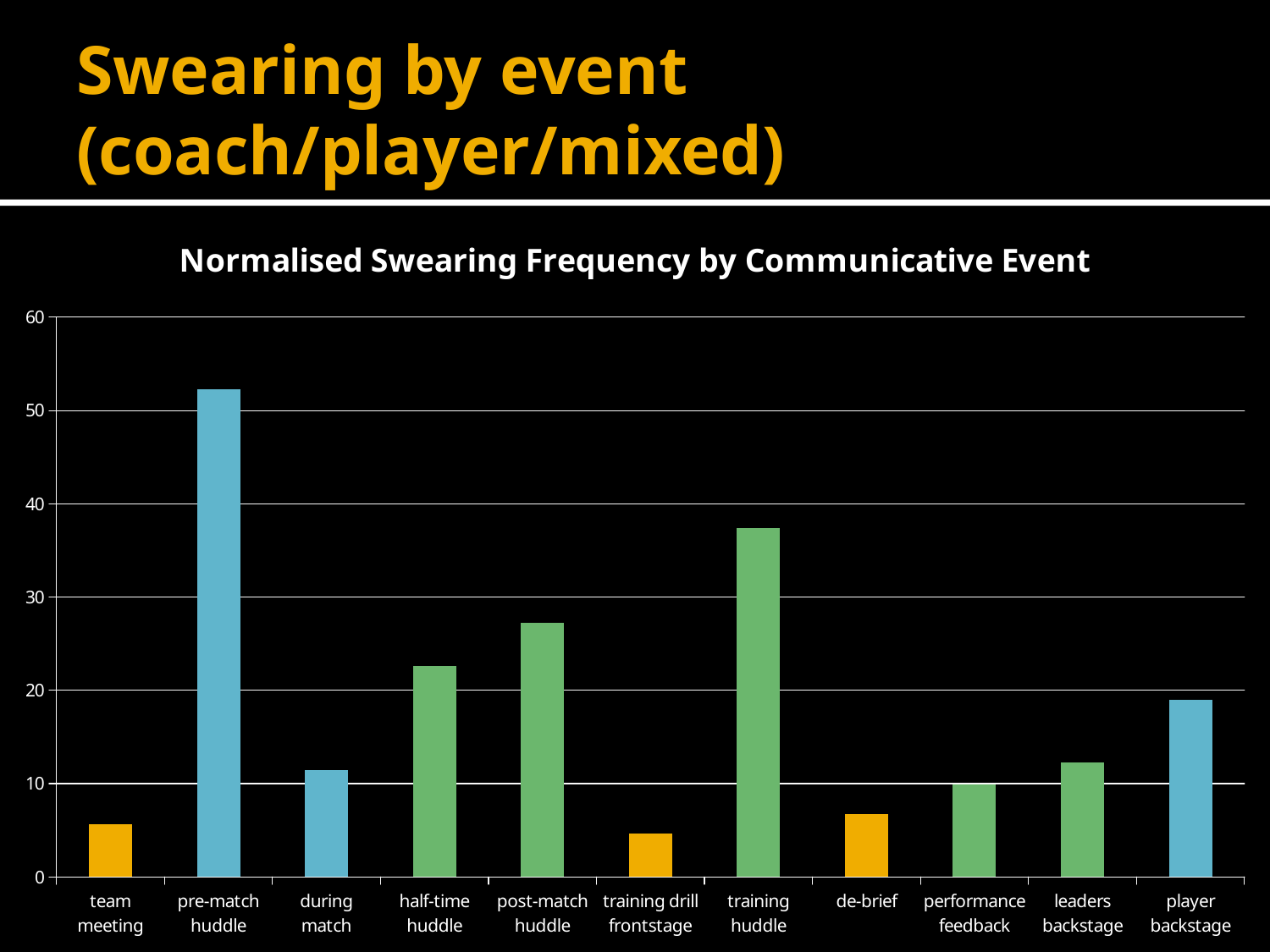
Is the value for post-match huddle greater or less than 30? less Is the value for pre-match huddle greater or less than 50? greater Which communicative event has the highest normalised swearing frequency? pre-match huddle Is the value for half-time huddle greater or less than 20? greater How many communicative events are shown on the x axis? 11 Which has a higher value, training huddle or post-match huddle? training huddle What colour is the bar for pre-match huddle? blue What is the title of the chart? Normalised Swearing Frequency by Communicative Event Which has a higher value, half-time huddle or player backstage? half-time huddle What kind of chart is shown on the slide? bar chart